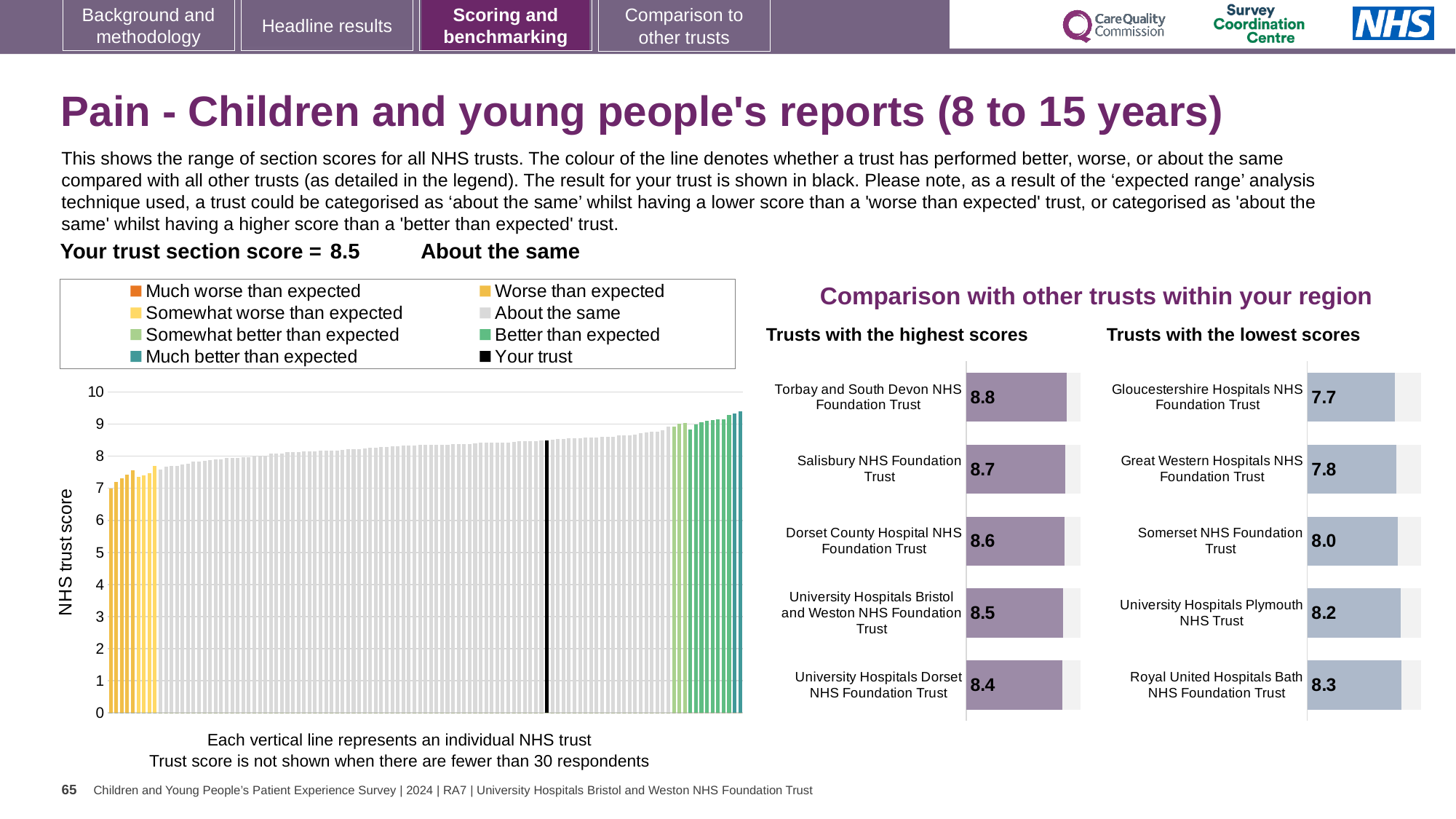
In the 'Trusts with the highest scores' chart, what is the difference between the scores of Torbay and South Devon NHS Foundation Trust and University Hospitals Dorset NHS Foundation Trust? 0.4 In the 'Trusts with the lowest scores' chart, what is the difference between the scores of Royal United Hospitals Bath NHS Foundation Trust and Gloucestershire Hospitals NHS Foundation Trust? 0.6 In the large chart on the left, do the trust scores rise or fall from left to right along the x axis? Rise In the 'Trusts with the lowest scores' chart, what is the score for Gloucestershire Hospitals NHS Foundation Trust? 7.7 In the 'Trusts with the highest scores' chart, what is the score for Torbay and South Devon NHS Foundation Trust? 8.8 In the 'Trusts with the highest scores' chart, which trust has the highest score? Torbay and South Devon NHS Foundation Trust In the large chart on the left, how many entries does the legend list? 8 In the 'Trusts with the lowest scores' chart, which trust has the lowest score? Gloucestershire Hospitals NHS Foundation Trust In the 'Trusts with the lowest scores' chart, which has the larger score: Somerset NHS Foundation Trust or Great Western Hospitals NHS Foundation Trust? Somerset NHS Foundation Trust In the 'Trusts with the highest scores' chart, how many trusts are shown? 5 In the large chart on the left, what is the label on the y axis? NHS trust score What kind of chart is the large chart on the left showing NHS trust scores? Bar chart